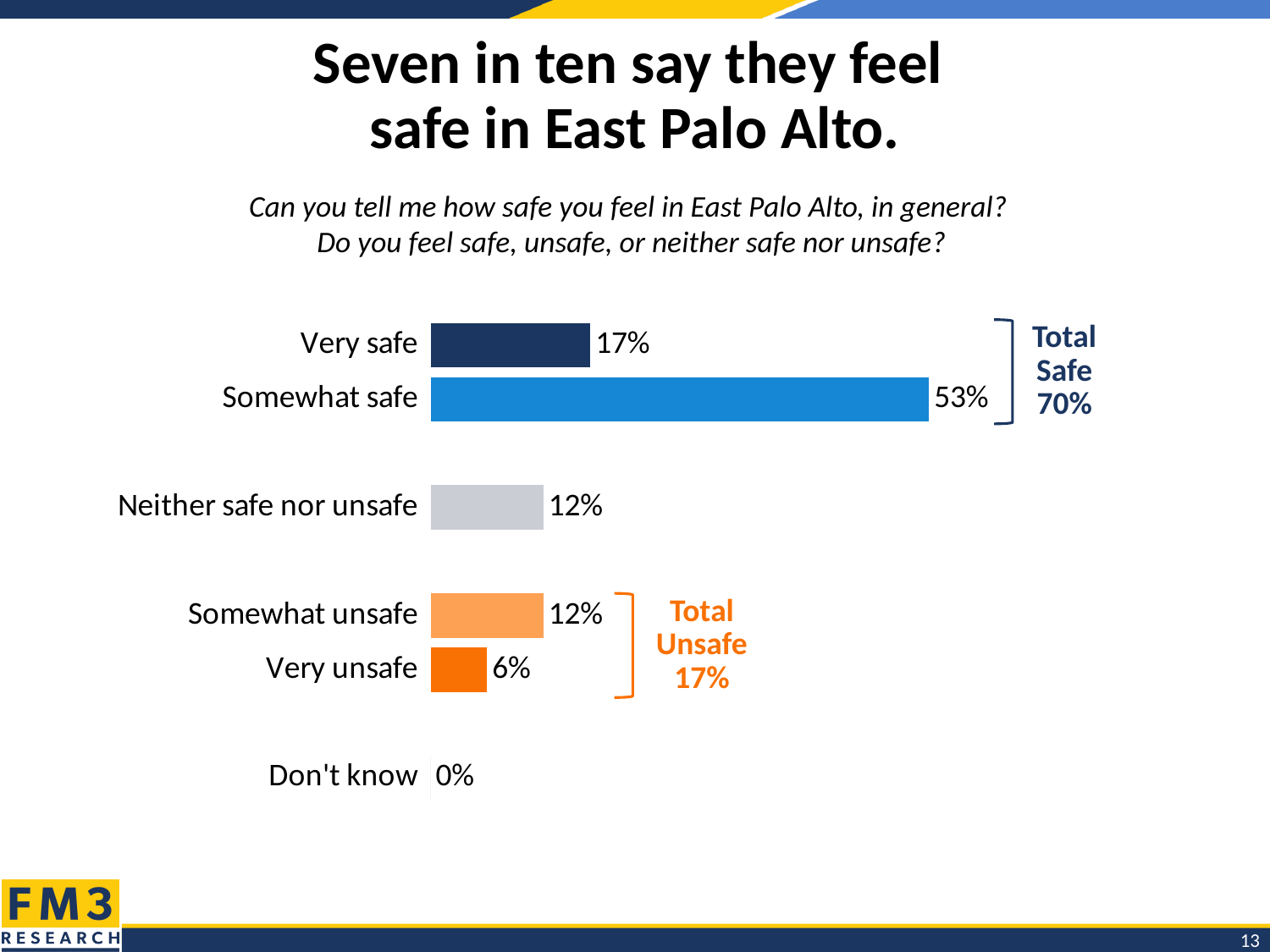
What is the Total Unsafe percentage shown on the chart? 17% What percentage of respondents said they feel very unsafe? 6% What is the Total Safe percentage shown on the chart? 70% Which response category has the highest percentage? Somewhat safe What percentage of respondents answered 'Don't know'? 0% What percentage of respondents said they feel somewhat safe? 53% What is the difference between the percentage who feel somewhat safe and the percentage who feel very safe? 36 percentage points What percentage of respondents said they feel very safe in East Palo Alto? 17% Which response category has the lowest percentage? Don't know Which is larger: the percentage who feel somewhat unsafe or the percentage who feel very unsafe? Somewhat unsafe What percentage of respondents said they feel neither safe nor unsafe? 12% What type of chart is shown on the slide? Bar chart